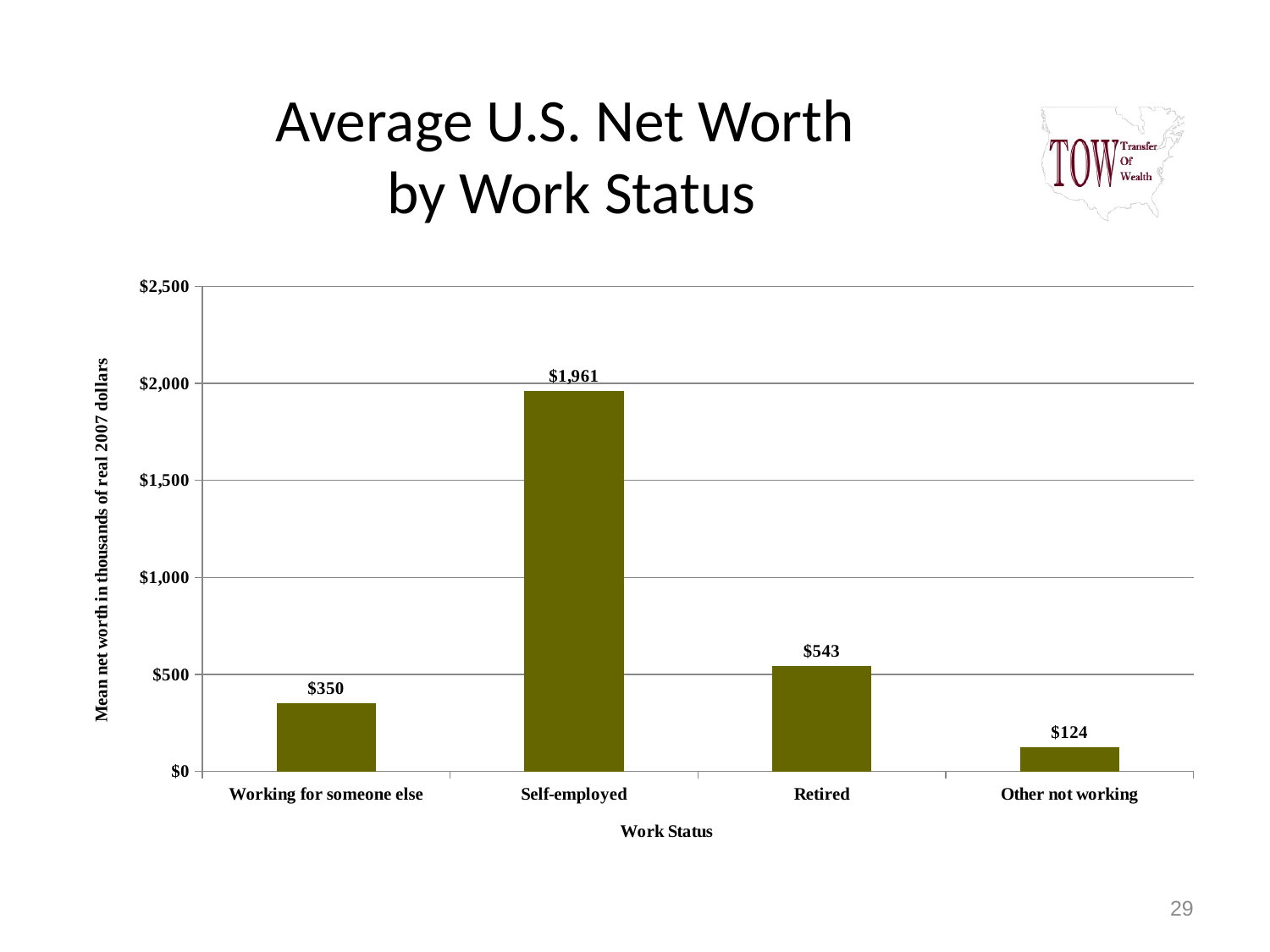
Is the value for Retired greater or less than $500? greater What is the mean net worth for Working for someone else? $350 How many work status categories are shown in the chart? 4 What is the mean net worth for Other not working? $124 Which work status has the lowest mean net worth? Other not working Which work status has the highest mean net worth? Self-employed What is the mean net worth for Retired? $543 Which has a higher mean net worth, Retired or Working for someone else? Retired What is the difference in mean net worth between Self-employed and Retired? $1,418 What kind of chart is shown on the slide? Bar chart What is the label of the vertical axis? Mean net worth in thousands of real 2007 dollars What is the mean net worth for Self-employed? $1,961